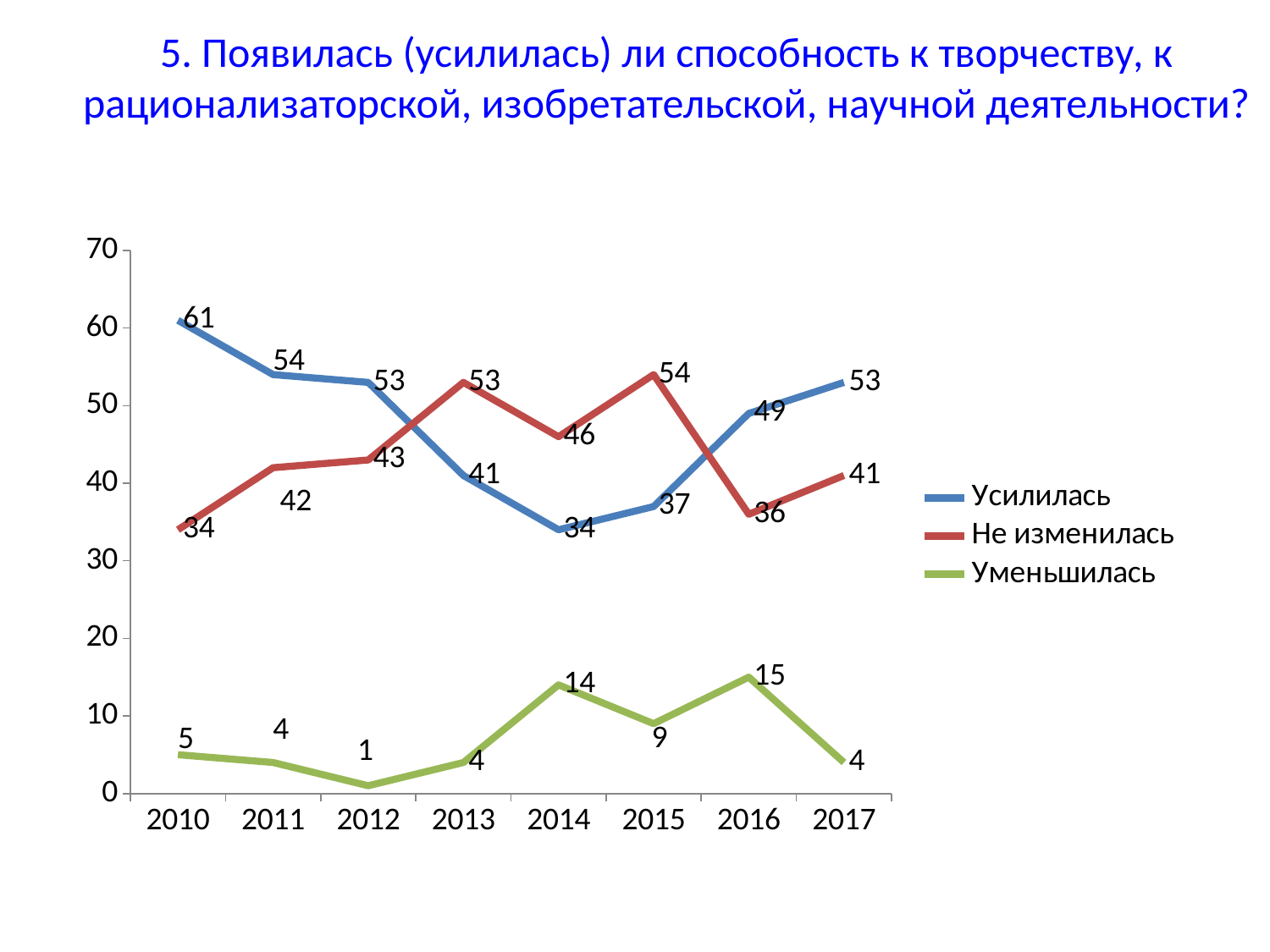
What is the value for Усилилась in 2010? 61 What is the value for Уменьшилась in 2016? 15 In which year is the value for Усилилась lowest? 2014 Does the value for Усилилась rise or fall from 2010 to 2014? fall In which year is the value for Уменьшилась highest? 2016 How many series does the legend list? 3 What is the value for Не изменилась in 2015? 54 What is the difference between the Усилилась value in 2010 and in 2014? 27 Which series has the larger value in 2013, Усилилась or Не изменилась? Не изменилась How many years are shown on the x axis? 8 What kind of chart is shown on the slide? line chart Is the value for Не изменилась in 2016 greater or less than 40? less